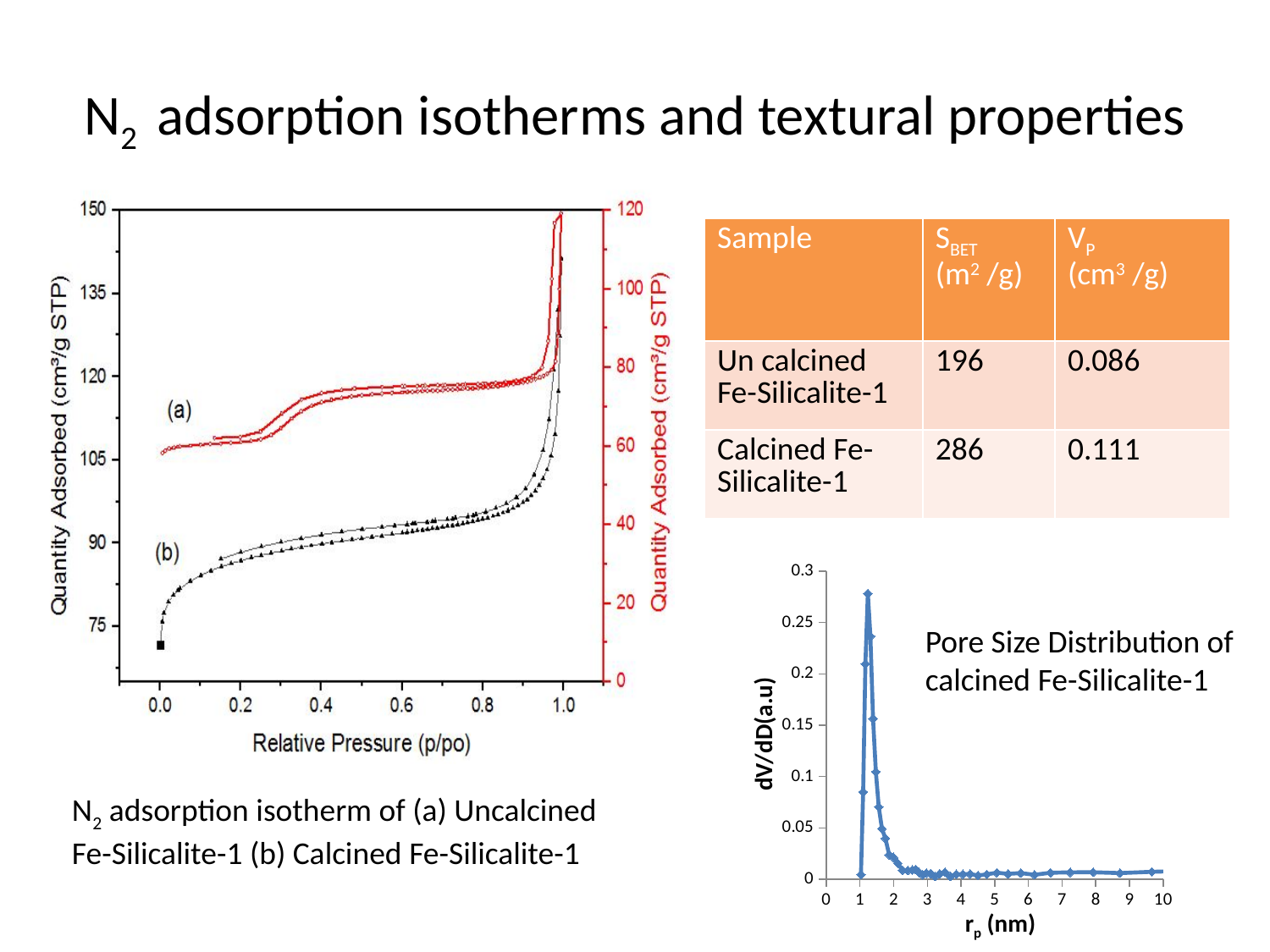
On the pore size distribution chart, what is the highest value shown on the y axis? 0.3 On the N2 adsorption isotherm chart, what kind of chart is it? line chart On the pore size distribution chart, what kind of chart is it? line chart On the pore size distribution chart, what is the label of the y axis? dV/dD(a.u) On the N2 adsorption isotherm chart, does the quantity adsorbed for curve (b) rise or fall as relative pressure increases? rise On the N2 adsorption isotherm chart, how many samples (curves) are plotted? 2 On the N2 adsorption isotherm chart, is the quantity adsorbed for curve (b) at relative pressure 0.0 greater or less than 75 cm³/g STP? less On the pore size distribution chart, does dV/dD rise or fall as rp increases from 2 nm to 10 nm? fall On the N2 adsorption isotherm chart, which curve corresponds to calcined Fe-Silicalite-1? (b) On the pore size distribution chart, is the peak value of dV/dD greater or less than 0.25? greater On the pore size distribution chart, is the value of dV/dD at rp = 5 nm greater or less than 0.05? less